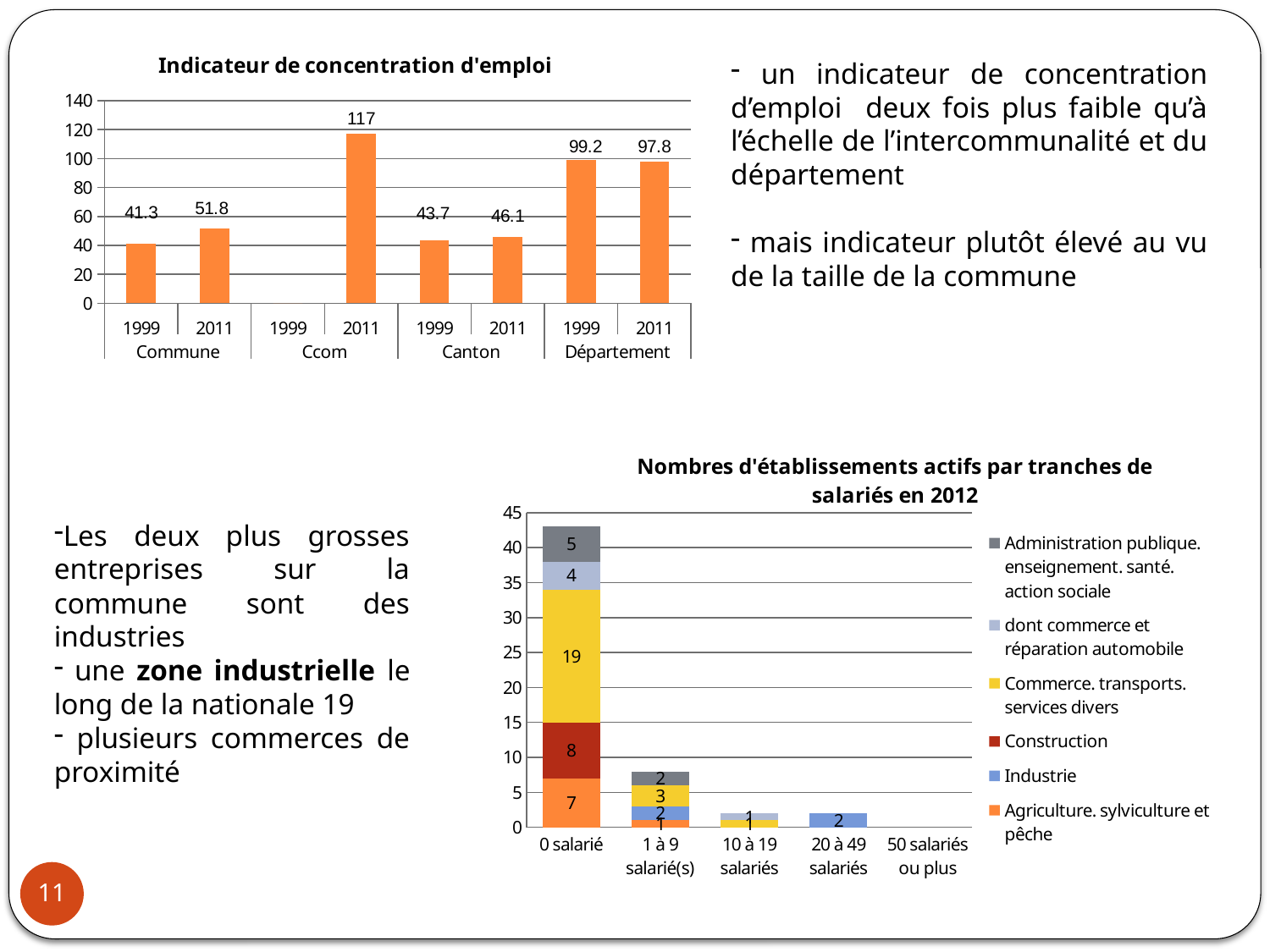
In the chart 'Indicateur de concentration d'emploi', which is larger: Canton 2011 or Commune 2011? Commune 2011 In the chart 'Indicateur de concentration d'emploi', is the value for Département in 1999 greater or less than 80? greater In the chart 'Indicateur de concentration d'emploi', what is the value for Ccom in 2011? 117 In the chart 'Nombres d'établissements actifs par tranches de salariés en 2012', what is the value for 'Industrie' in the '20 à 49 salariés' category? 2 What kind of chart is 'Nombres d'établissements actifs par tranches de salariés en 2012'? stacked bar chart In the chart 'Nombres d'établissements actifs par tranches de salariés en 2012', what is the total of the stacked bar for '0 salarié'? 43 How many series does the legend of the chart 'Nombres d'établissements actifs par tranches de salariés en 2012' list? 6 In the chart 'Indicateur de concentration d'emploi', what is the value for Département in 2011? 97.8 In the chart 'Nombres d'établissements actifs par tranches de salariés en 2012', what is the value for 'Commerce. transports. services divers' in the '0 salarié' category? 19 In the chart 'Indicateur de concentration d'emploi', what is the difference between the Commune values for 2011 and 1999? 10.5 In the chart 'Indicateur de concentration d'emploi', what is the value for Commune in 1999? 41.3 In the chart 'Indicateur de concentration d'emploi', which bar has the highest value? Ccom 2011